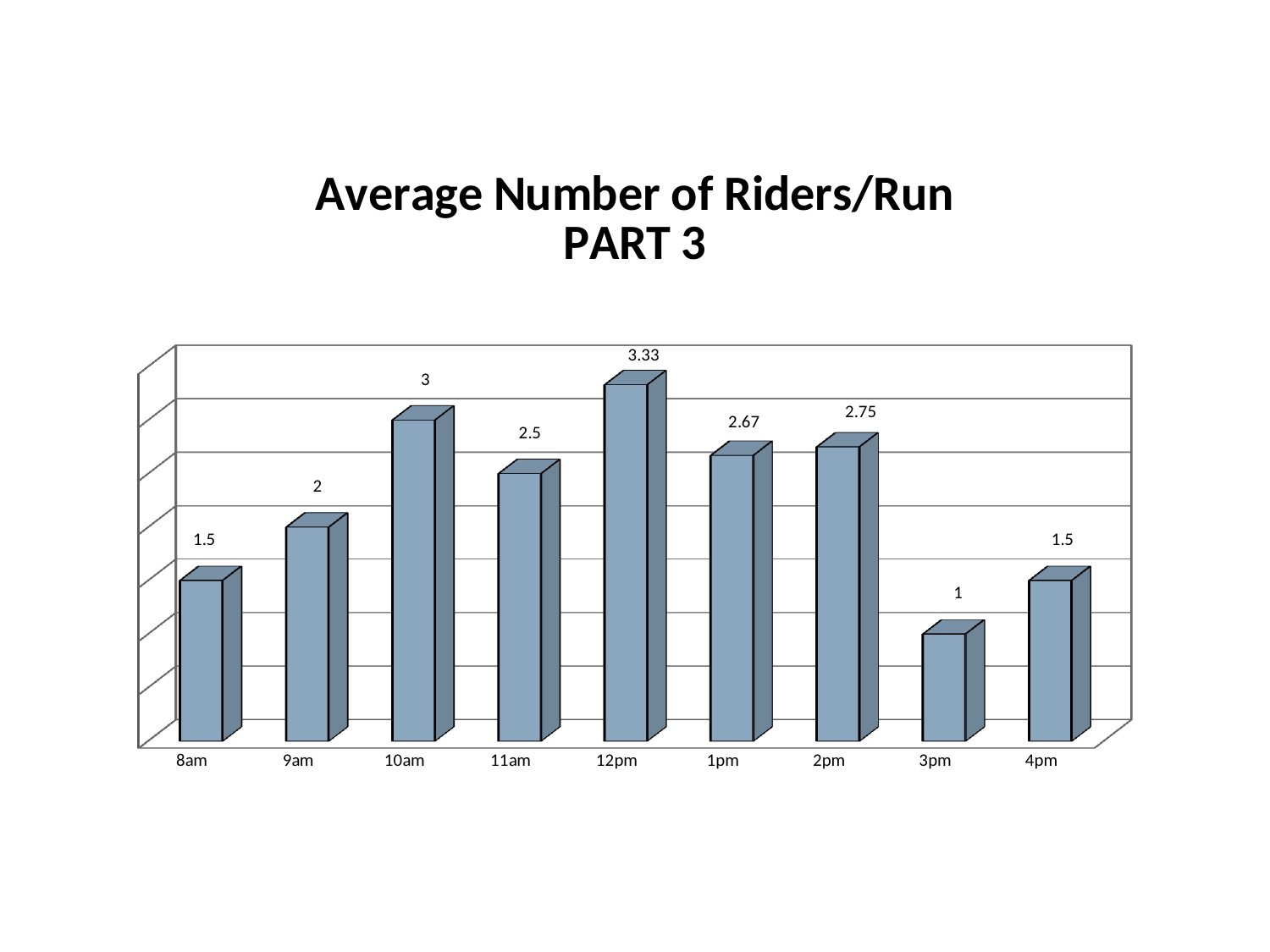
Which time has the lowest average number of riders per run? 3pm Do the values rise or fall from 8am to 12pm? rise How many time categories are shown on the x axis? 9 Which has a higher average number of riders per run, 1pm or 2pm? 2pm What kind of chart is shown on the slide? bar chart What is the difference between the average number of riders per run at 12pm and at 3pm? 2.33 What is the average number of riders per run at 12pm? 3.33 What is the difference between the average number of riders per run at 10am and at 11am? 0.5 What is the average number of riders per run at 9am? 2 What is the average number of riders per run at 2pm? 2.75 What is the title of the chart? Average Number of Riders/Run PART 3 Which time has the highest average number of riders per run? 12pm